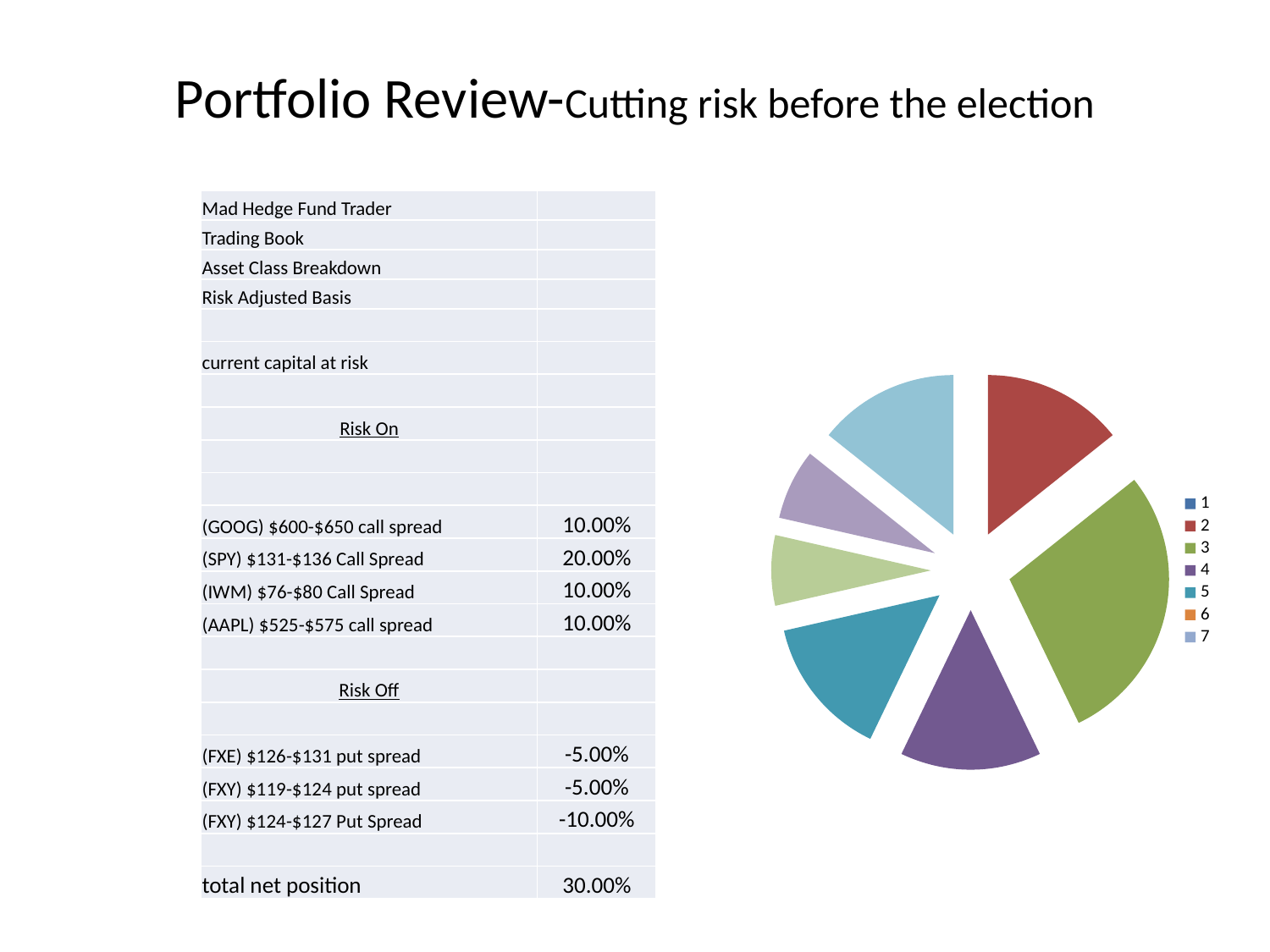
What colour is the largest slice of the pie chart? green What kind of chart is shown on the slide? pie chart Which legend entry is shown in red in the pie chart's legend? 2 How many entries does the legend of the pie chart list? 7 Which legend entry corresponds to the largest slice of the pie chart? 3